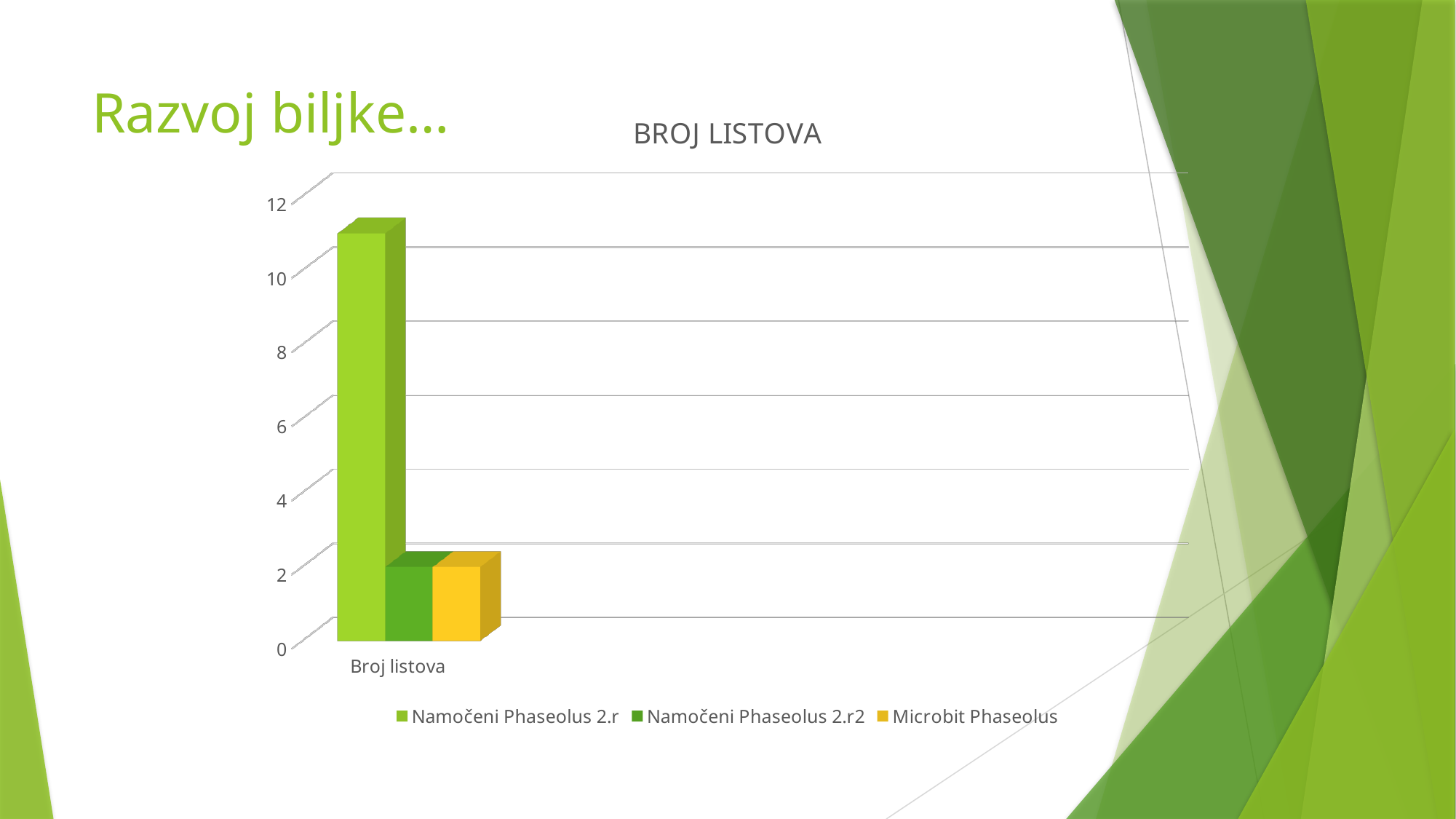
Is the value for Microbit Phaseolus greater or less than 6? less Is the value for Namočeni Phaseolus 2.r2 greater or less than 4? less What is the title of the chart? BROJ LISTOVA Which series has the highest value for Broj listova? Namočeni Phaseolus 2.r How many series does the legend list? 3 What is the label of the category on the x axis? Broj listova Is the value for Namočeni Phaseolus 2.r greater or less than 10? greater Which is larger, the value for Namočeni Phaseolus 2.r or the value for Namočeni Phaseolus 2.r2? Namočeni Phaseolus 2.r What kind of chart is shown on the slide? bar chart How many categories are shown on the x axis? 1 Which is larger, the value for Namočeni Phaseolus 2.r or the value for Microbit Phaseolus? Namočeni Phaseolus 2.r